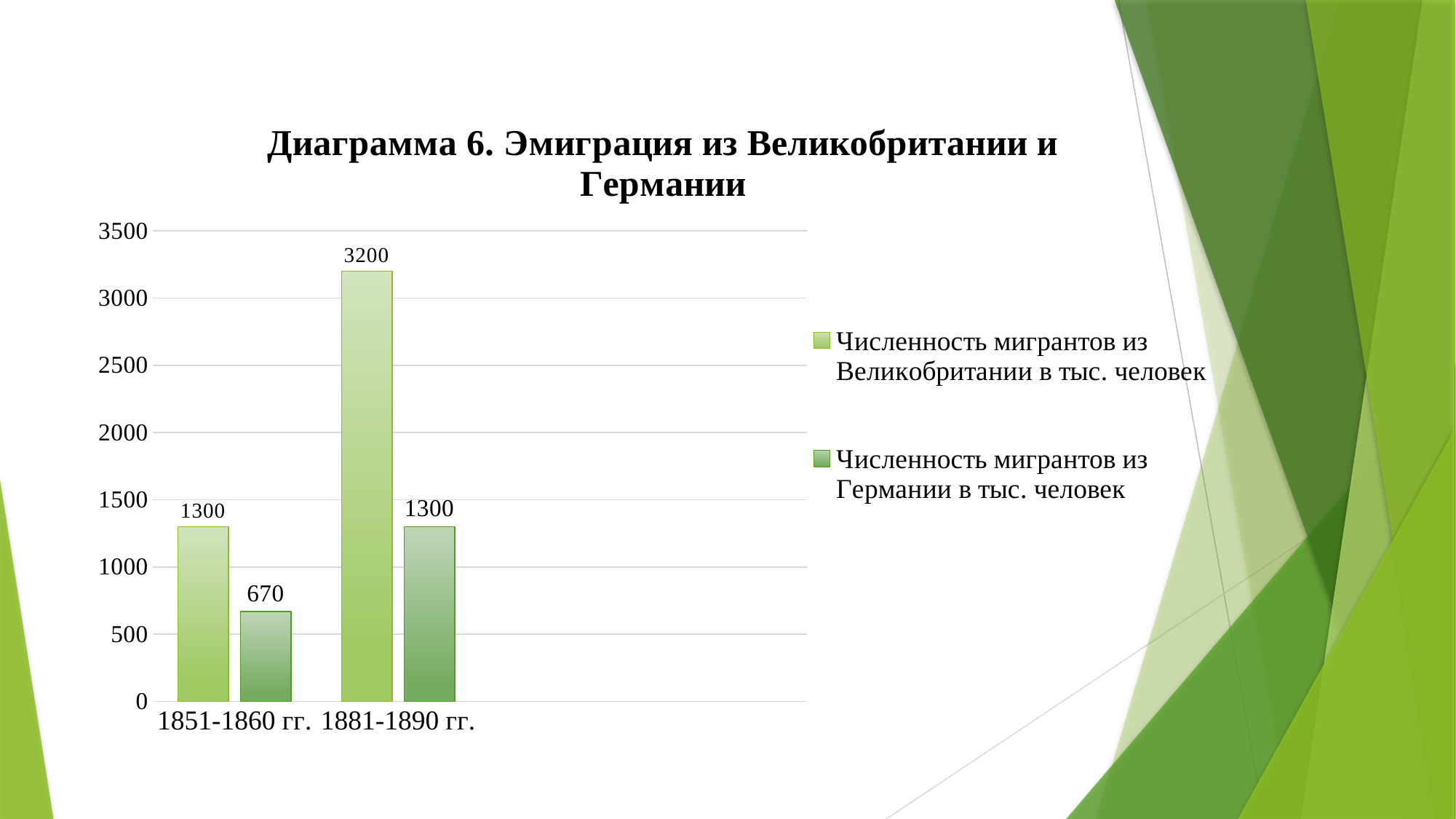
What is the number of migrants from Germany (in thousands) for 1851-1860 гг.? 670 Which period has the lowest value for migrants from Germany? 1851-1860 гг. Which period has the highest value for migrants from Great Britain? 1881-1890 гг. How many periods are shown on the x axis? 2 What is the number of migrants from Great Britain (in thousands) for 1881-1890 гг.? 3200 In 1851-1860 гг., which is larger: migrants from Great Britain or migrants from Germany? Migrants from Great Britain By how much did the number of migrants from Germany increase from 1851-1860 гг. to 1881-1890 гг.? 630 What is the difference between migrants from Great Britain and migrants from Germany in 1881-1890 гг.? 1900 How many series does the legend list? 2 What is the number of migrants from Germany (in thousands) for 1881-1890 гг.? 1300 What is the number of migrants from Great Britain (in thousands) for 1851-1860 гг.? 1300 What type of chart is shown on the slide? Bar chart